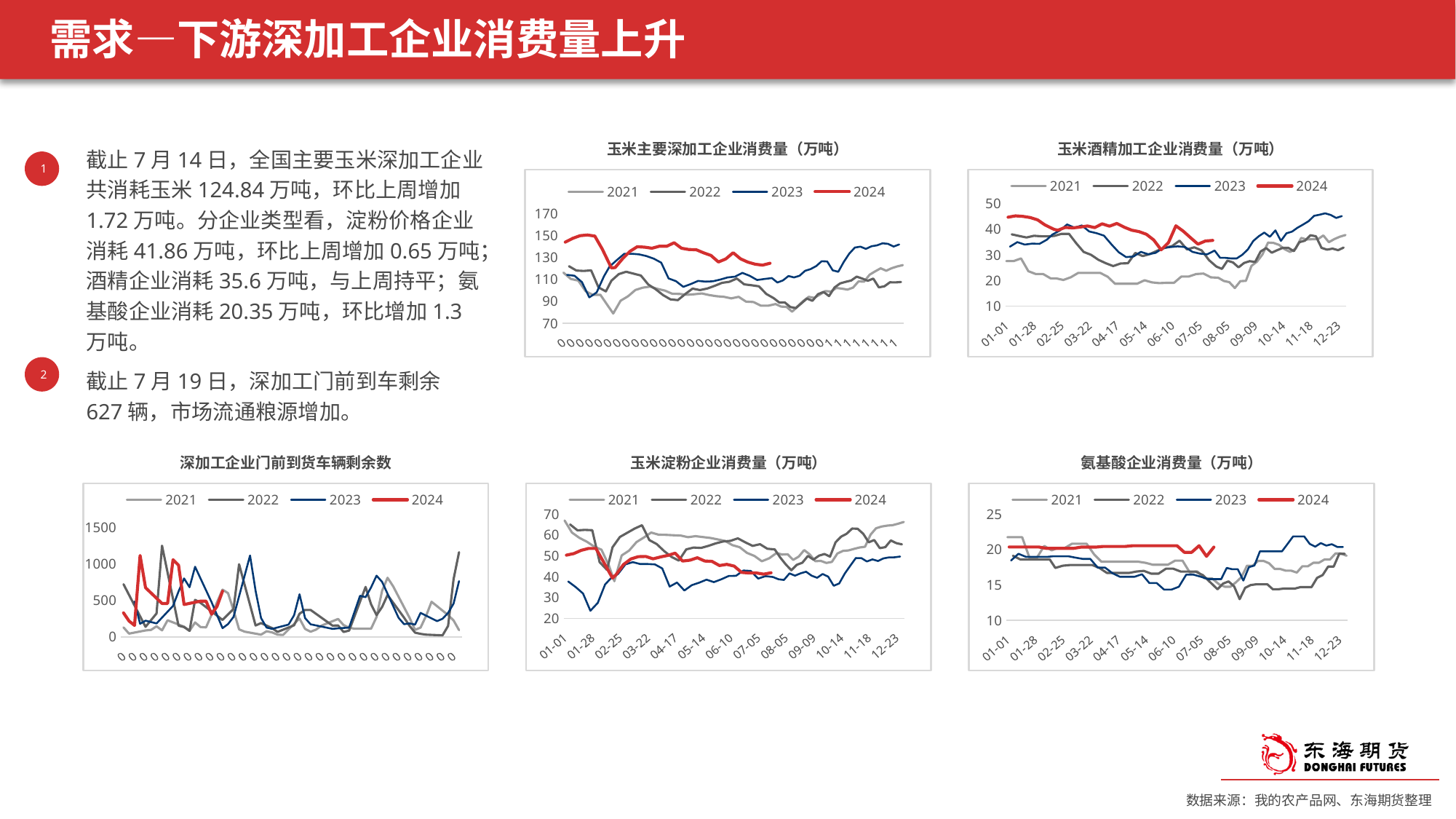
How many series does the legend list in the chart titled 玉米淀粉企业消费量（万吨）? 4 In the chart titled 氨基酸企业消费量（万吨）, is the value of the 2024 series at 01-01 greater or less than 15? greater In the chart titled 深加工企业门前到货车辆剩余数, is the highest value of the 2024 series greater or less than 1500? less In the chart titled 玉米酒精加工企业消费量（万吨）, does the 2024 series overall rise or fall from 01-01 to its last point? fall What kind of chart is the one titled 玉米主要深加工企业消费量（万吨）? line chart In the chart titled 玉米酒精加工企业消费量（万吨）, is the value of the 2024 series at 01-01 greater or less than 40? greater In the chart titled 氨基酸企业消费量（万吨）, which years are listed in the legend? 2021, 2022, 2023, 2024 In the chart titled 玉米主要深加工企业消费量（万吨）, at the first point on the x axis, which series is higher: 2024 or 2021? 2024 In the chart titled 玉米主要深加工企业消费量（万吨）, does the 2024 series overall rise or fall from its first point to its last point? fall In the chart titled 玉米主要深加工企业消费量（万吨）, which series is drawn in red? 2024